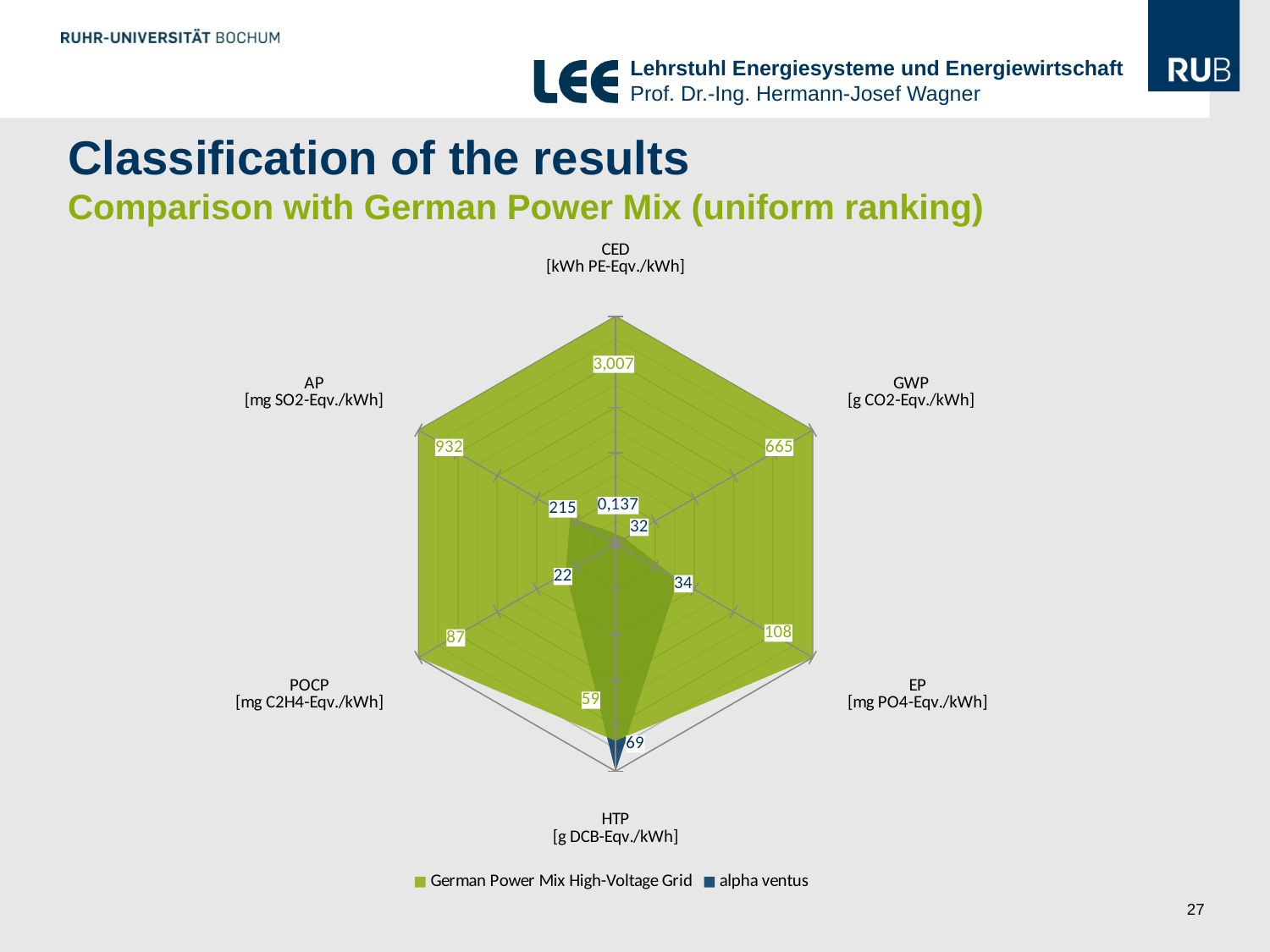
What kind of chart is shown on the slide? Radar chart How many series does the legend list? 2 What is the value for alpha ventus on the HTP axis? 69 What is the value for German Power Mix High-Voltage Grid on the CED axis? 3,007 What is the value for alpha ventus on the AP axis? 215 What is the difference between the German Power Mix High-Voltage Grid and alpha ventus values on the AP axis? 717 What is the difference between the German Power Mix High-Voltage Grid and alpha ventus values on the EP axis? 74 What is the value for German Power Mix High-Voltage Grid on the GWP axis? 665 What is the value for German Power Mix High-Voltage Grid on the POCP axis? 87 Which series has the larger value on the HTP axis, German Power Mix High-Voltage Grid or alpha ventus? alpha ventus How many axes (impact categories) does the chart have? 6 Which series has the larger value on the EP axis, German Power Mix High-Voltage Grid or alpha ventus? German Power Mix High-Voltage Grid